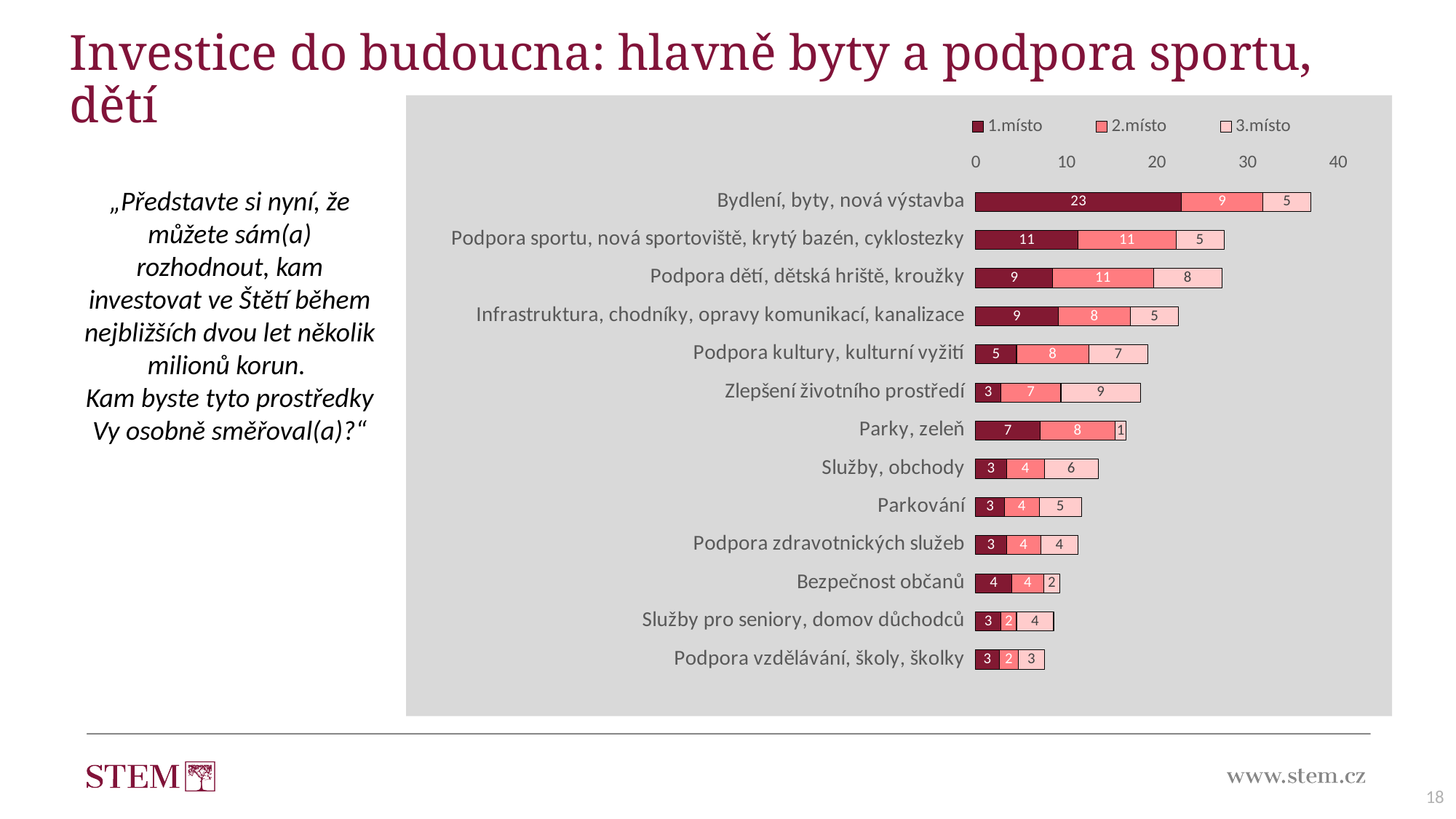
What is the difference between the 1.místo values for "Bydlení, byty, nová výstavba" and "Podpora sportu, nová sportoviště, krytý bazén, cyklostezky"? 12 What is the total of the stacked bar for "Podpora kultury, kulturní vyžití"? 20 What is the 3.místo value for "Zlepšení životního prostředí"? 9 How many categories are shown in the chart? 13 What kind of chart is shown on the slide? Stacked bar chart Which category has the lowest 3.místo value? Parky, zeleň What is the 1.místo value for "Bydlení, byty, nová výstavba"? 23 What is the total of the stacked bar for "Bydlení, byty, nová výstavba"? 37 What is the 2.místo value for "Podpora dětí, dětská hřiště, kroužky"? 11 Which category has the highest 1.místo value? Bydlení, byty, nová výstavba How many series does the legend list? 3 Which is larger: the 3.místo value for "Podpora dětí, dětská hřiště, kroužky" or the 3.místo value for "Infrastruktura, chodníky, opravy komunikací, kanalizace"? Podpora dětí, dětská hřiště, kroužky